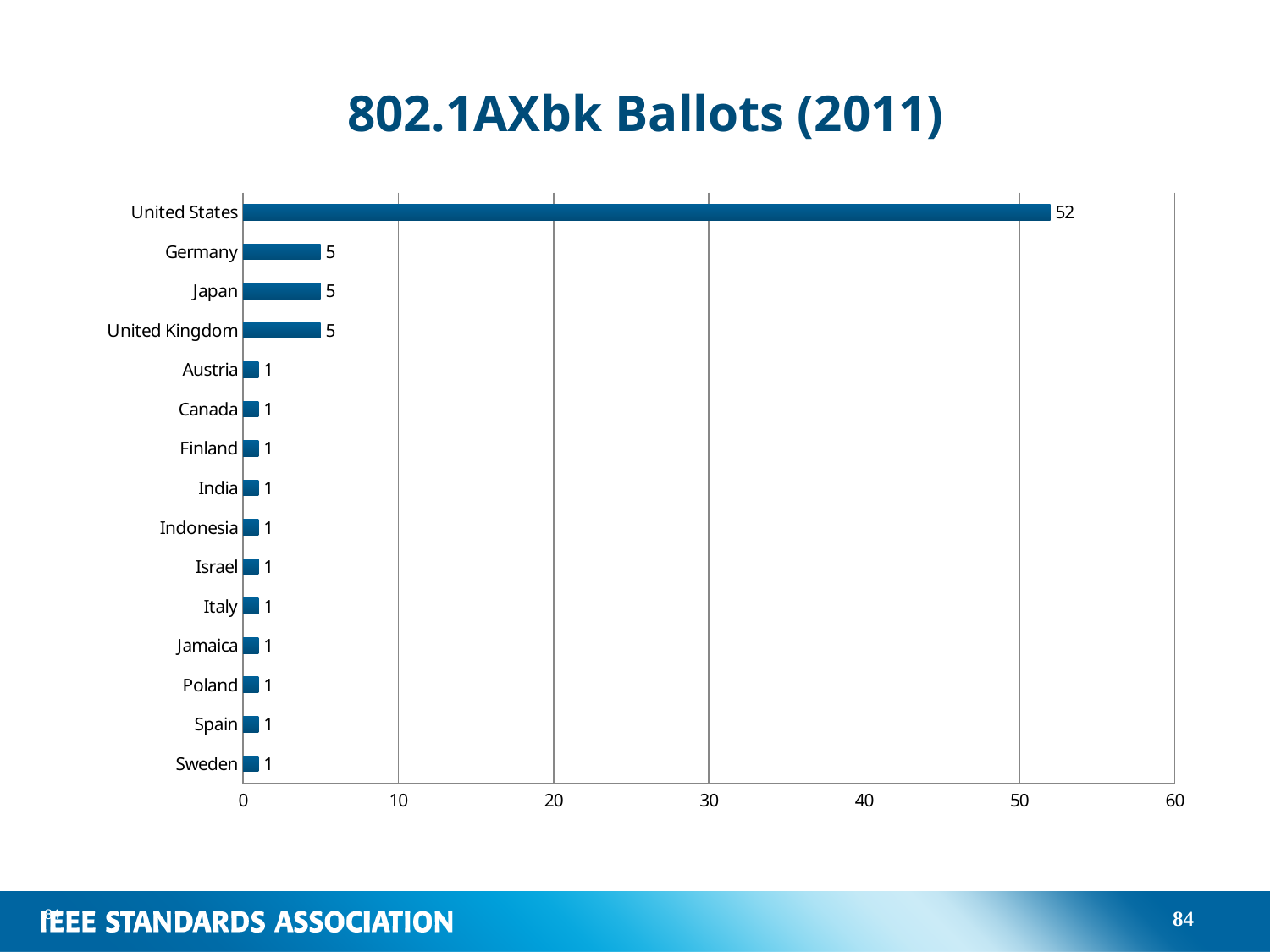
How many categories have a value of 1? 11 Which category has the highest value? United States What is the title of the chart? 802.1AXbk Ballots (2011) What is the difference between the values for United States and Japan? 47 What is the value for Jamaica? 1 What is the value for Germany? 5 Which is larger, the value for Germany or the value for Canada? Germany What kind of chart is shown on the slide? bar chart What is the difference between the values for United Kingdom and Austria? 4 How many categories are shown on the chart? 15 Is the value for United States greater or less than 50? greater What is the value for United States? 52